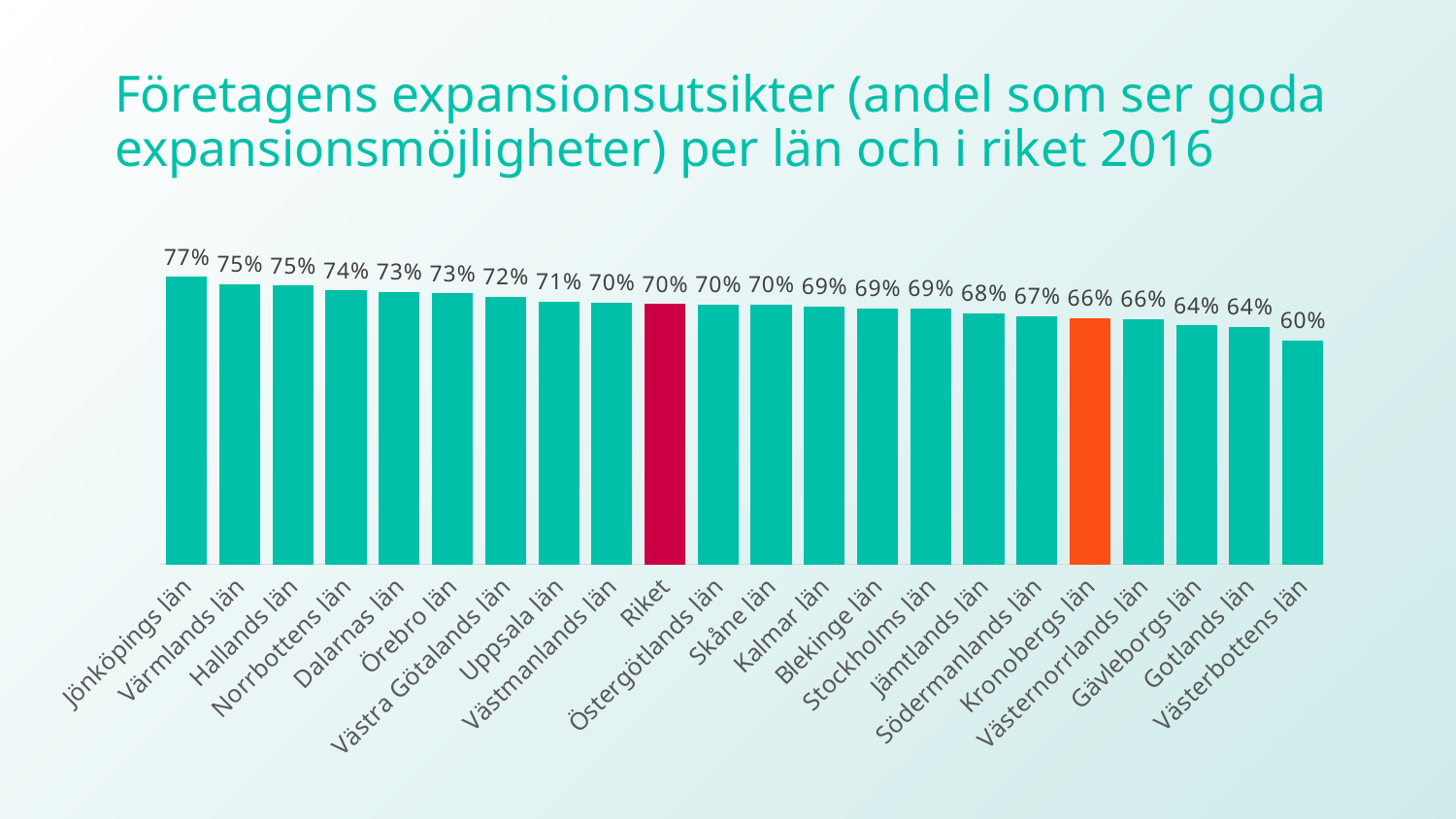
What is the difference between the values for Riket and Kronobergs län? 4 percentage points What is the value for Jönköpings län? 77% Which is larger, the value for Norrbottens län or the value for Gotlands län? Norrbottens län Which category has the highest value? Jönköpings län What is the value for Stockholms län? 69% Which bar is coloured orange? Kronobergs län What is the difference between the values for Jönköpings län and Västerbottens län? 17 percentage points What is the value for Kronobergs län? 66% How many bars are shown in the chart? 22 Which category has the lowest value? Västerbottens län What is the value for Riket? 70% What kind of chart is shown on the slide? Bar chart